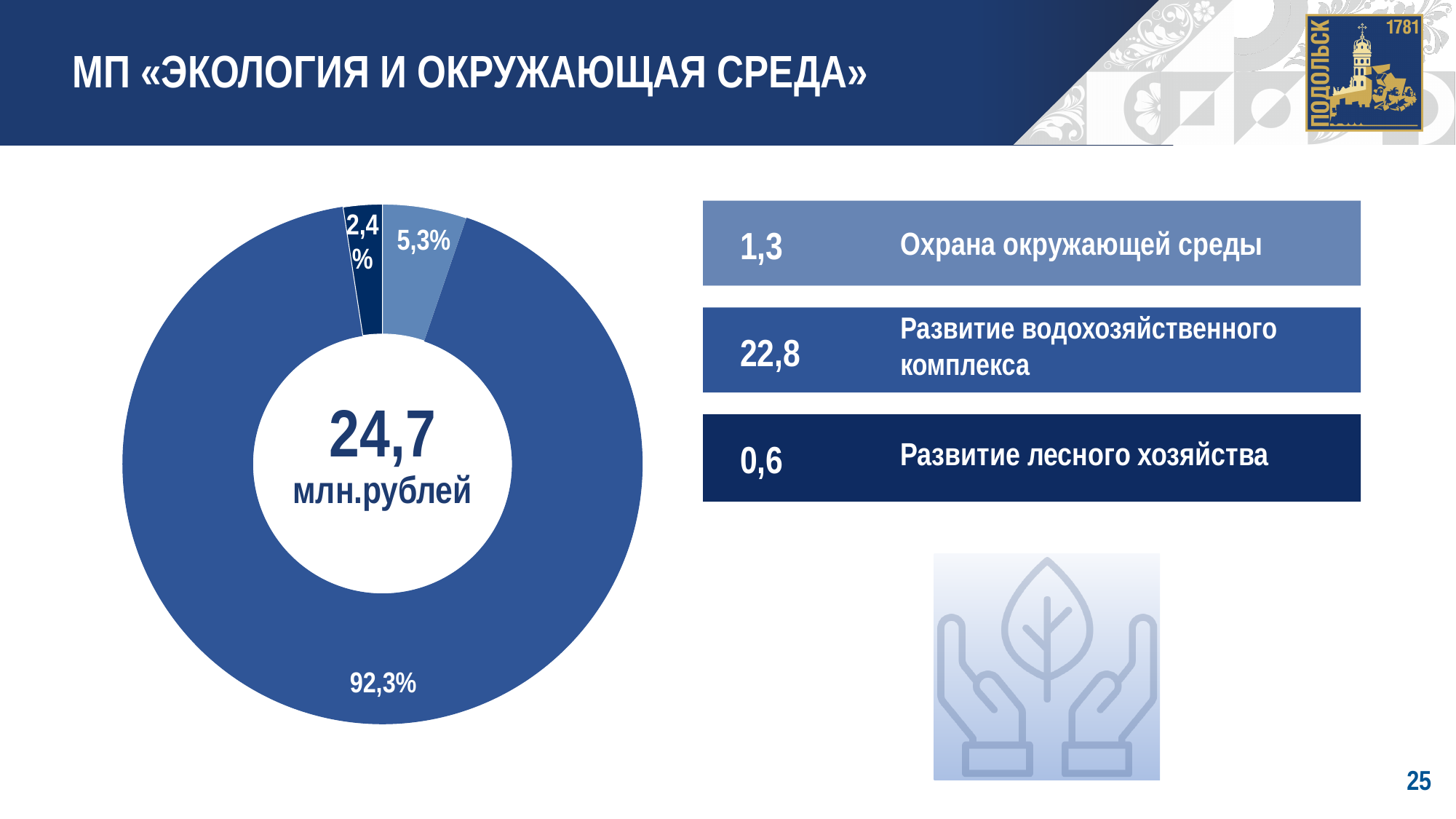
What value is shown for Развитие водохозяйственного комплекса? 22,8 What share of the donut chart does the largest slice represent? 92,3% What kind of chart is shown on the slide? Pie chart (donut) What share of the donut chart does the dark navy slice (Развитие лесного хозяйства) represent? 2,4% What share of the donut chart does the light blue slice (Охрана окружающей среды) represent? 5,3% Which is larger: the share for Охрана окружающей среды or the share for Развитие лесного хозяйства? Охрана окружающей среды What is the difference in percentage points between the 5,3% slice and the 2,4% slice? 2,9% What is the total amount shown in the centre of the donut chart? 24,7 млн.рублей Which category has the largest share in the donut chart? Развитие водохозяйственного комплекса How many slices does the donut chart have? 3 What value is shown for Охрана окружающей среды? 1,3 Which category has the smallest share in the donut chart? Развитие лесного хозяйства